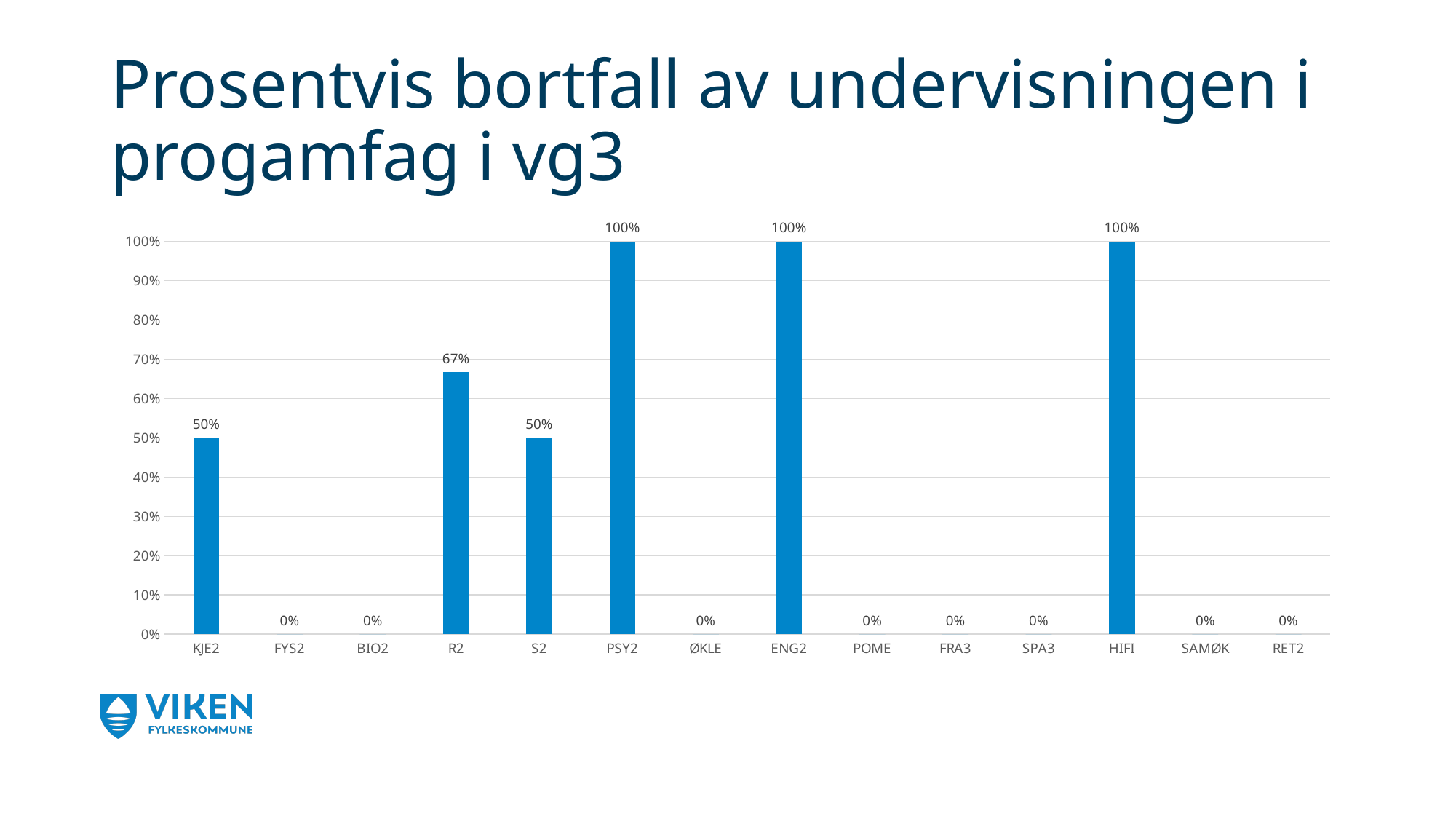
How many categories are shown on the x axis? 14 What is the value for KJE2? 50% What is the title of the slide? Prosentvis bortfall av undervisningen i progamfag i vg3 What is the value for R2? 67% What is the value for HIFI? 100% What kind of chart is shown on the slide? Bar chart Which categories have the highest value? PSY2, ENG2 and HIFI What is the difference between the values for R2 and S2? 17% Which is larger, the value for R2 or the value for KJE2? R2 What is the value for ØKLE? 0% Is the value for R2 greater or less than 60%? greater How many categories have a value of 0%? 9